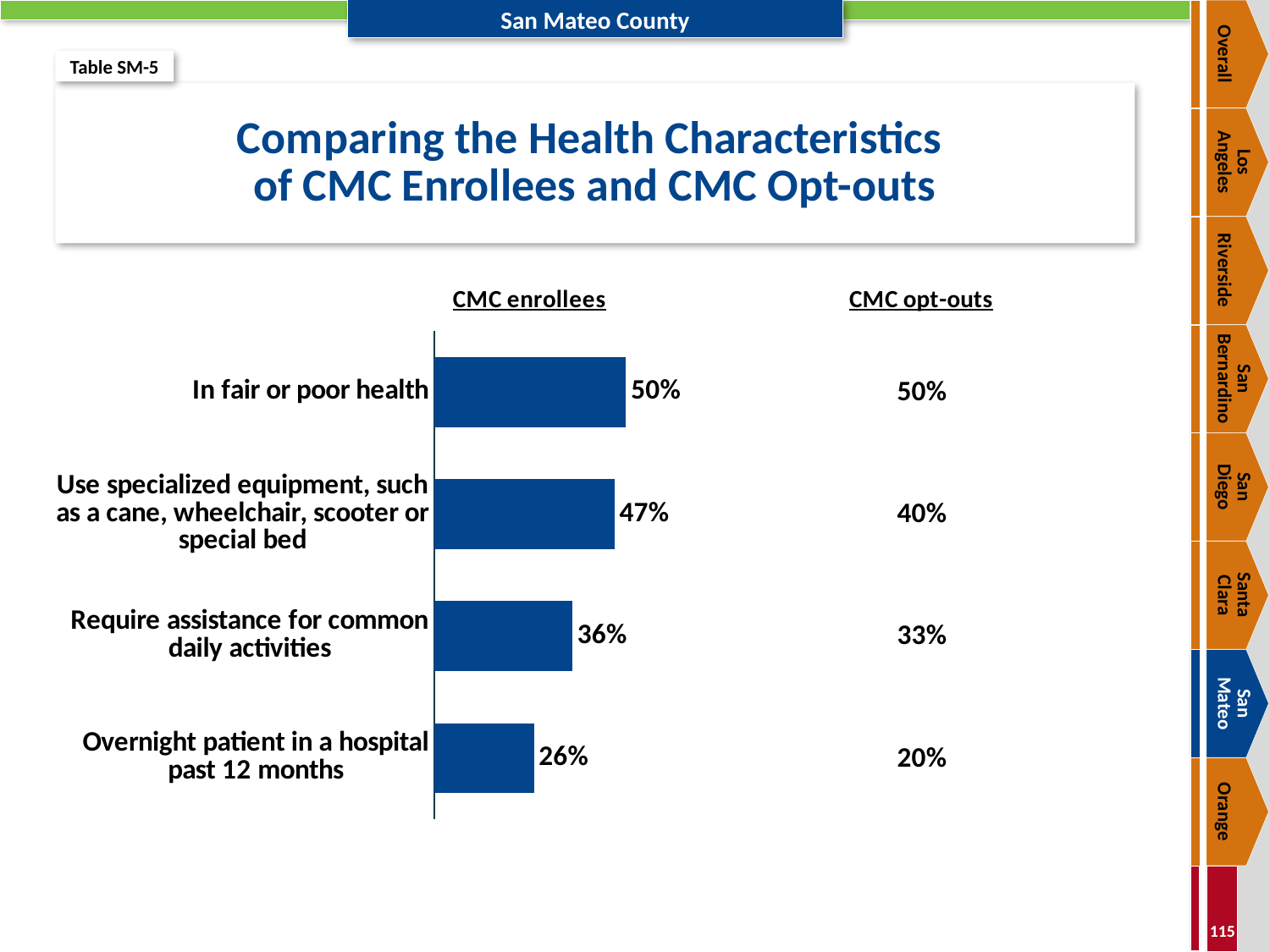
What is the difference between CMC enrollees and CMC opt-outs for being an overnight patient in a hospital in the past 12 months? 6% How many health characteristics are shown in the chart? 4 What is the title of the chart? Comparing the Health Characteristics of CMC Enrollees and CMC Opt-outs Which group has a higher percentage requiring assistance for common daily activities, CMC enrollees or CMC opt-outs? CMC enrollees What percentage of CMC opt-outs use specialized equipment, such as a cane, wheelchair, scooter or special bed? 40% What type of chart is used to show the CMC enrollees values? Bar chart What percentage of CMC opt-outs were an overnight patient in a hospital in the past 12 months? 20% What percentage of CMC enrollees require assistance for common daily activities? 36% Which health characteristic has the lowest percentage among CMC enrollees? Overnight patient in a hospital past 12 months What percentage of CMC enrollees are in fair or poor health? 50% Which health characteristic has the highest percentage among CMC enrollees? In fair or poor health What is the difference between CMC enrollees and CMC opt-outs for using specialized equipment? 7%